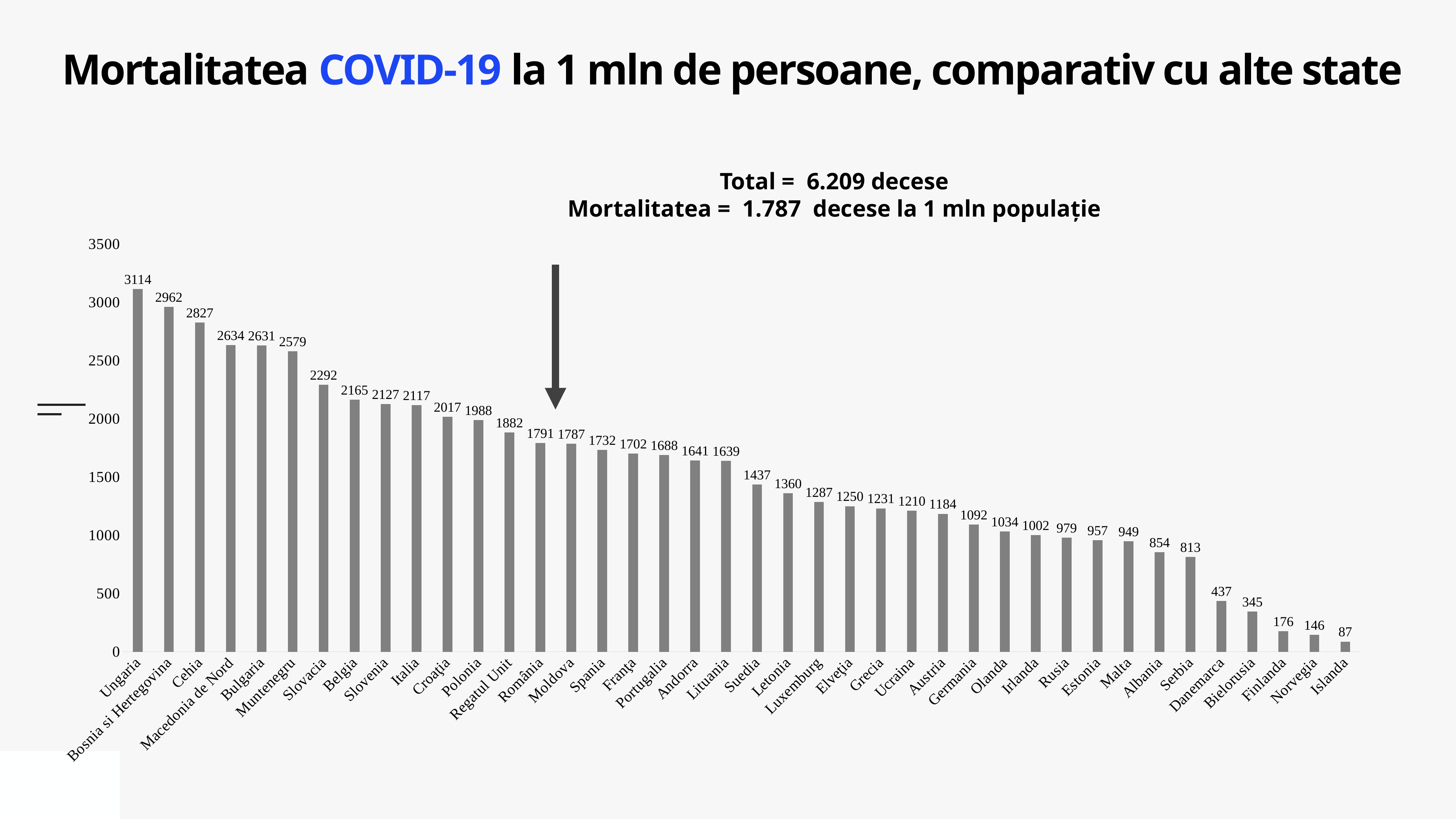
What is the COVID-19 mortality per 1 mln people shown for Moldova? 1787 Which country has the highest mortality per 1 mln people on the chart? Ungaria What is the difference between the values for Ungaria and Islanda? 3027 Do the values rise or fall from left to right along the x axis? Fall How many countries are shown on the chart? 40 What value is shown for Ungaria? 3114 Which has a higher value, Germania or Serbia? Germania Is the value for Danemarca greater or less than 500? less What kind of chart is shown on the slide? Bar chart What value is shown for România? 1791 What is the difference between the values for România and Moldova? 4 Which country has the lowest mortality per 1 mln people on the chart? Islanda